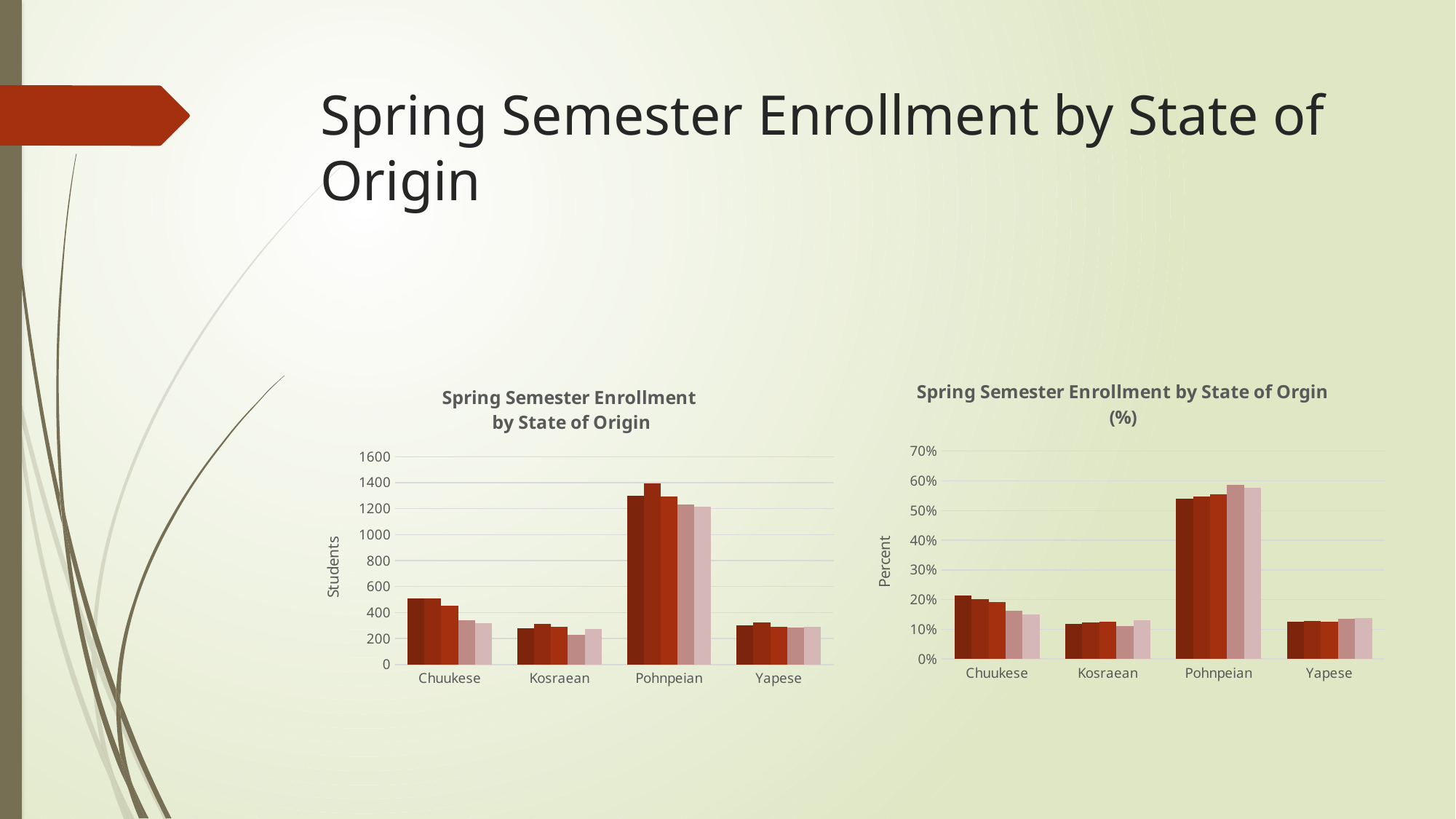
How many states of origin are shown on the x axis of the left chart? 4 What is the y-axis label of the left chart? Students In the left chart (Students), are the values for Pohnpeian greater or less than 1000? greater How many categories are shown on the x axis of the right chart (%)? 4 In the right chart (Percent), are the values for Pohnpeian greater or less than 50%? greater What is the y-axis label of the right chart? Percent In the left chart (Students), which state of origin has the highest enrollment? Pohnpeian In the right chart (Percent), which state of origin has the highest share? Pohnpeian In the right chart (Percent), are the values for Chuukese greater or less than 30%? less In the left chart (Students), which has higher enrollment, Chuukese or Kosraean? Chuukese What kind of chart is the left chart titled "Spring Semester Enrollment by State of Origin"? bar chart